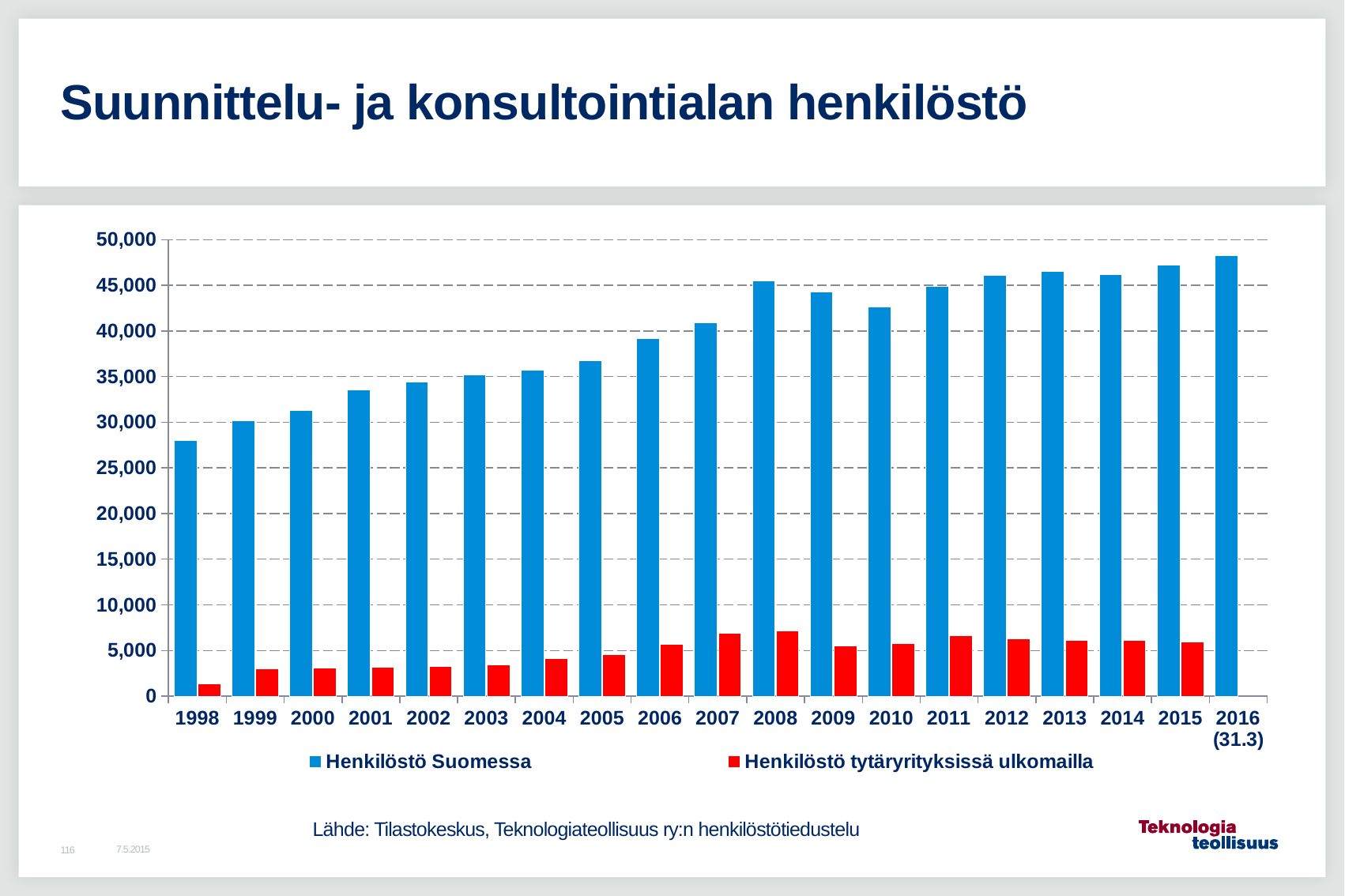
Is the value for Henkilöstö tytäryrityksissä ulkomailla in 2008 greater or less than 5,000? greater Is the value for Henkilöstö Suomessa in 2010 greater or less than 40,000? greater Does Henkilöstö Suomessa generally rise or fall from 1998 to 2016? rise Which is larger for Henkilöstö Suomessa: 2008 or 2009? 2008 Is the value for Henkilöstö Suomessa in 2016 (31.3) greater or less than 45,000? greater How many series does the legend list? 2 What kind of chart is shown on the slide? bar chart How many years (categories) are shown on the x axis? 19 Which year has the lowest value for Henkilöstö tytäryrityksissä ulkomailla? 1998 Which year has the highest value for Henkilöstö Suomessa? 2016 (31.3) Which year has the lowest value for Henkilöstö Suomessa? 1998